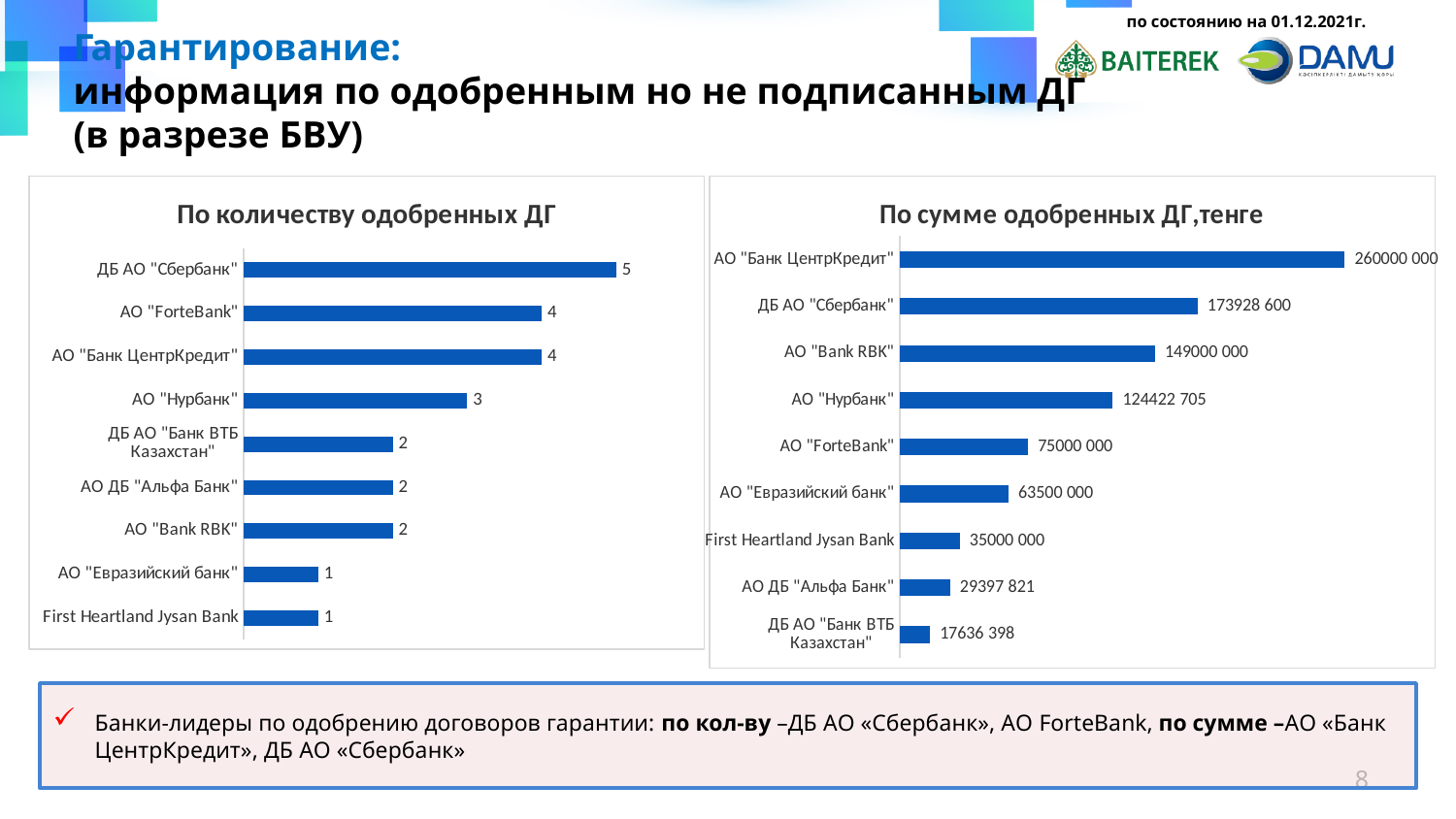
In the chart "По сумме одобренных ДГ,тенге", which bank has the lowest value? ДБ АО "Банк ВТБ Казахстан" What is the title of the chart on the left side of the slide? По количеству одобренных ДГ In the chart "По количеству одобренных ДГ", which bank has the highest value? ДБ АО "Сбербанк" In the chart "По количеству одобренных ДГ", what is the value for АО "Нурбанк"? 3 What type of chart is "По сумме одобренных ДГ,тенге"? Bar chart In the chart "По сумме одобренных ДГ,тенге", which is larger: АО "ForteBank" or АО "Евразийский банк"? АО "ForteBank" In the chart "По количеству одобренных ДГ", what is the difference between ДБ АО "Сбербанк" and АО "Евразийский банк"? 4 In the chart "По количеству одобренных ДГ", how many banks are shown? 9 In the chart "По сумме одобренных ДГ,тенге", what is the value for АО "Bank RBK"? 149000 000 In the chart "По сумме одобренных ДГ,тенге", what is the value for First Heartland Jysan Bank? 35000 000 In the chart "По количеству одобренных ДГ", what is the value for ДБ АО "Сбербанк"? 5 In the chart "По сумме одобренных ДГ,тенге", what is the value for АО "Банк ЦентрКредит"? 260000 000